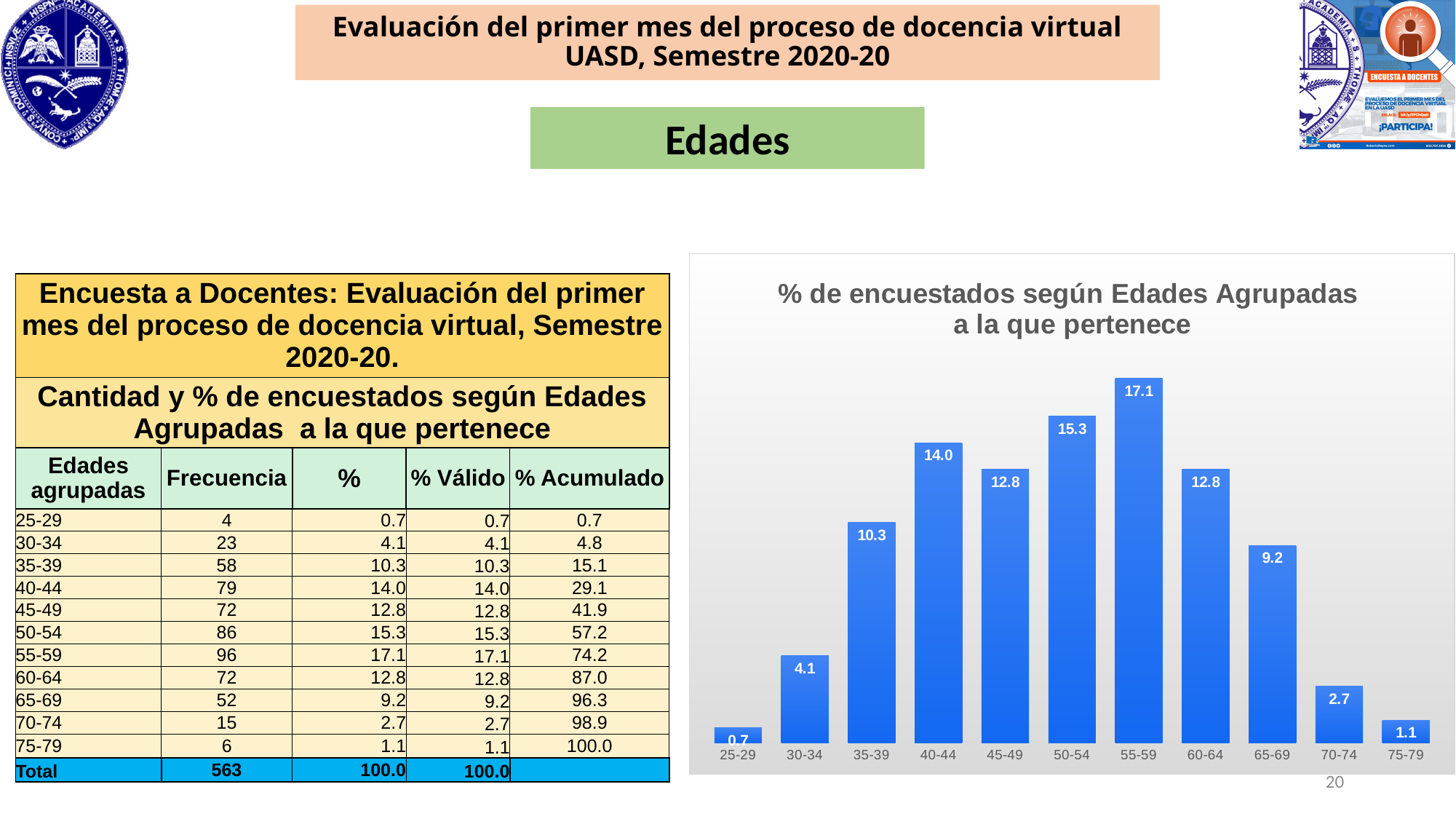
What is the value for the 35-39 age group in the chart? 10.3 What is the difference between the values for 55-59 and 50-54 in the chart? 1.8 Do the values rise or fall from 55-59 to 75-79 along the x axis? Fall Which age group has the lowest value in the chart? 25-29 Which is larger in the chart, the value for 65-69 or the value for 35-39? 35-39 What is the difference between the values for 40-44 and 30-34 in the chart? 9.9 What kind of chart is shown on the slide? Bar chart How many age groups are shown in the chart? 11 What is the value for the 55-59 age group in the chart? 17.1 What is the title of the chart? % de encuestados según Edades Agrupadas a la que pertenece Which age group has the highest value in the chart? 55-59 What is the value for the 70-74 age group in the chart? 2.7